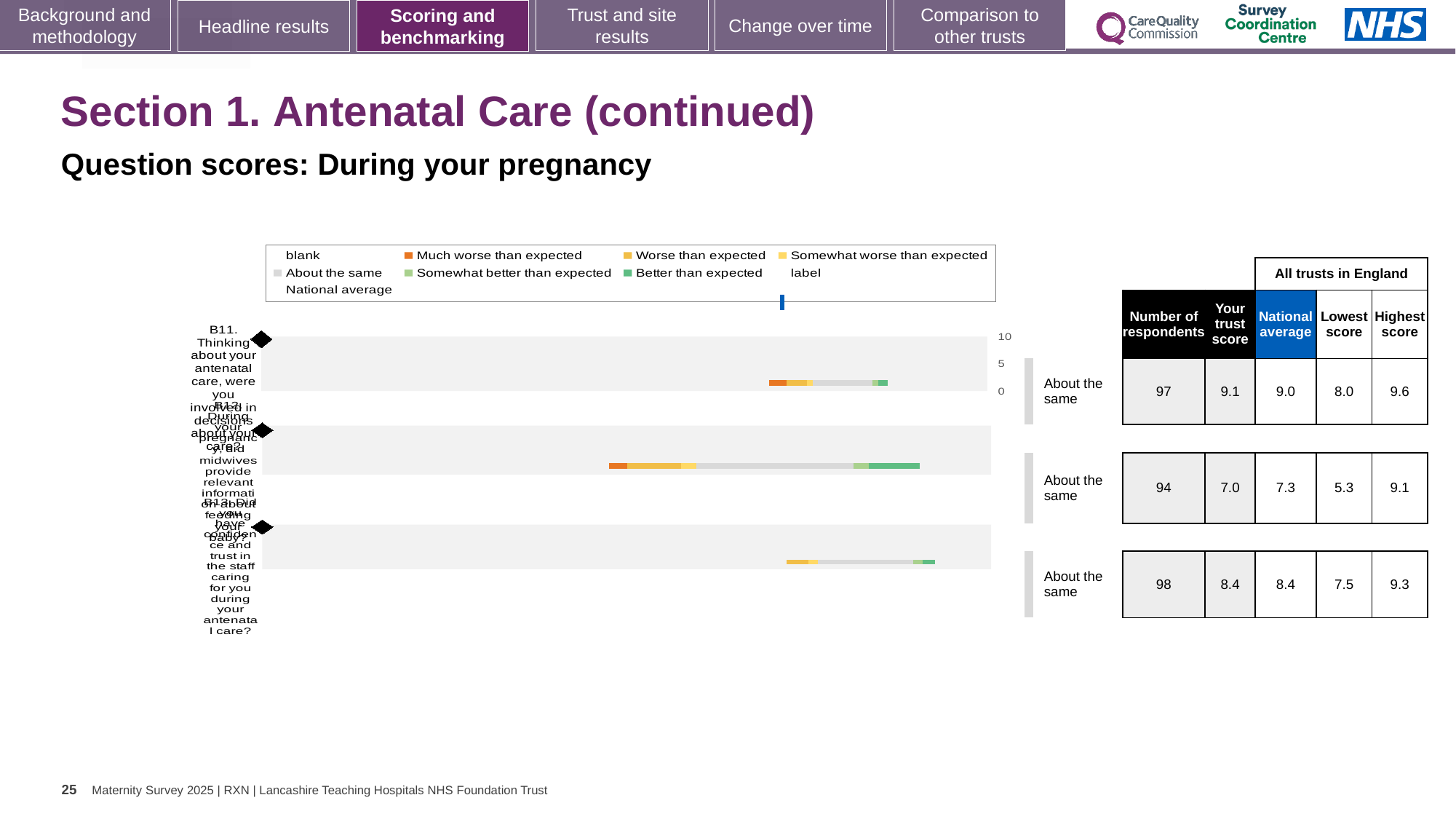
What colour does the legend use for 'Much worse than expected'? orange What is the difference between the highest score and the lowest score for question B12? 3.8 How many questions (categories) are plotted in the chart? 3 What is the lowest score across all trusts in England for question B12? 5.3 Which question has the fewest respondents? B12 Which question has the highest trust score? B11 What colour does the legend use for 'Better than expected'? green What is the benchmark rating shown next to question B12? About the same What is the trust score for question B12? 7.0 What is the number of respondents for question B11? 97 What is the national average for question B13? 8.4 What kind of chart is shown on the slide? bar chart